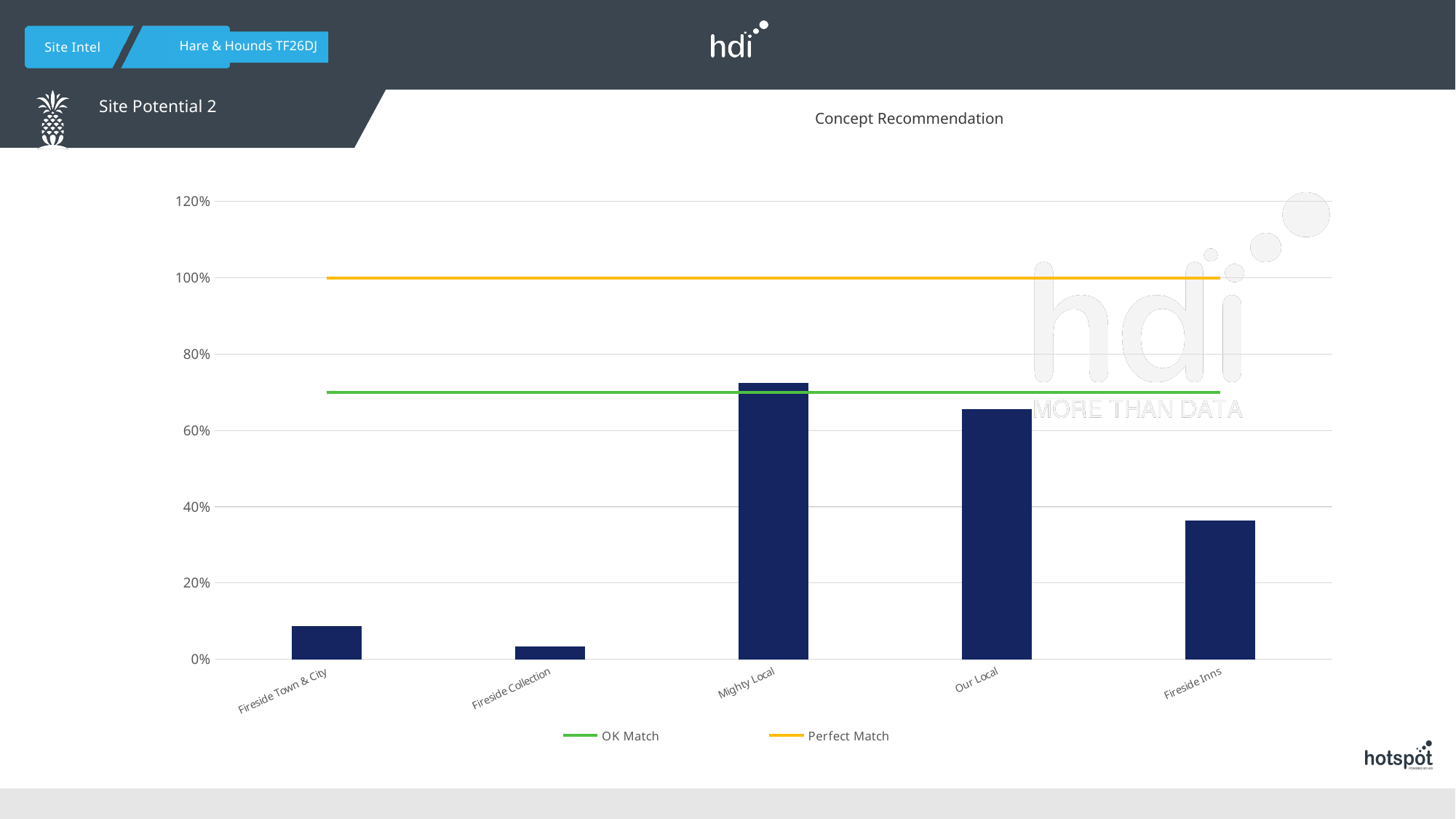
How many entries does the chart's legend list? 2 Is the value for Mighty Local greater or less than 60%? greater Which is larger, the value for Our Local or the value for Fireside Inns? Our Local Which is larger, the value for Fireside Town & City or the value for Fireside Collection? Fireside Town & City What kind of chart is shown on the slide? combination bar and line chart How many categories are shown on the x axis of the chart? 5 Which category has the lowest bar? Fireside Collection What is the title shown above the chart? Concept Recommendation Is the value for Fireside Inns greater or less than 40%? less At what value on the y axis is the Perfect Match line drawn? 100% Is the value for Fireside Town & City greater or less than 20%? less Which category has the highest bar? Mighty Local